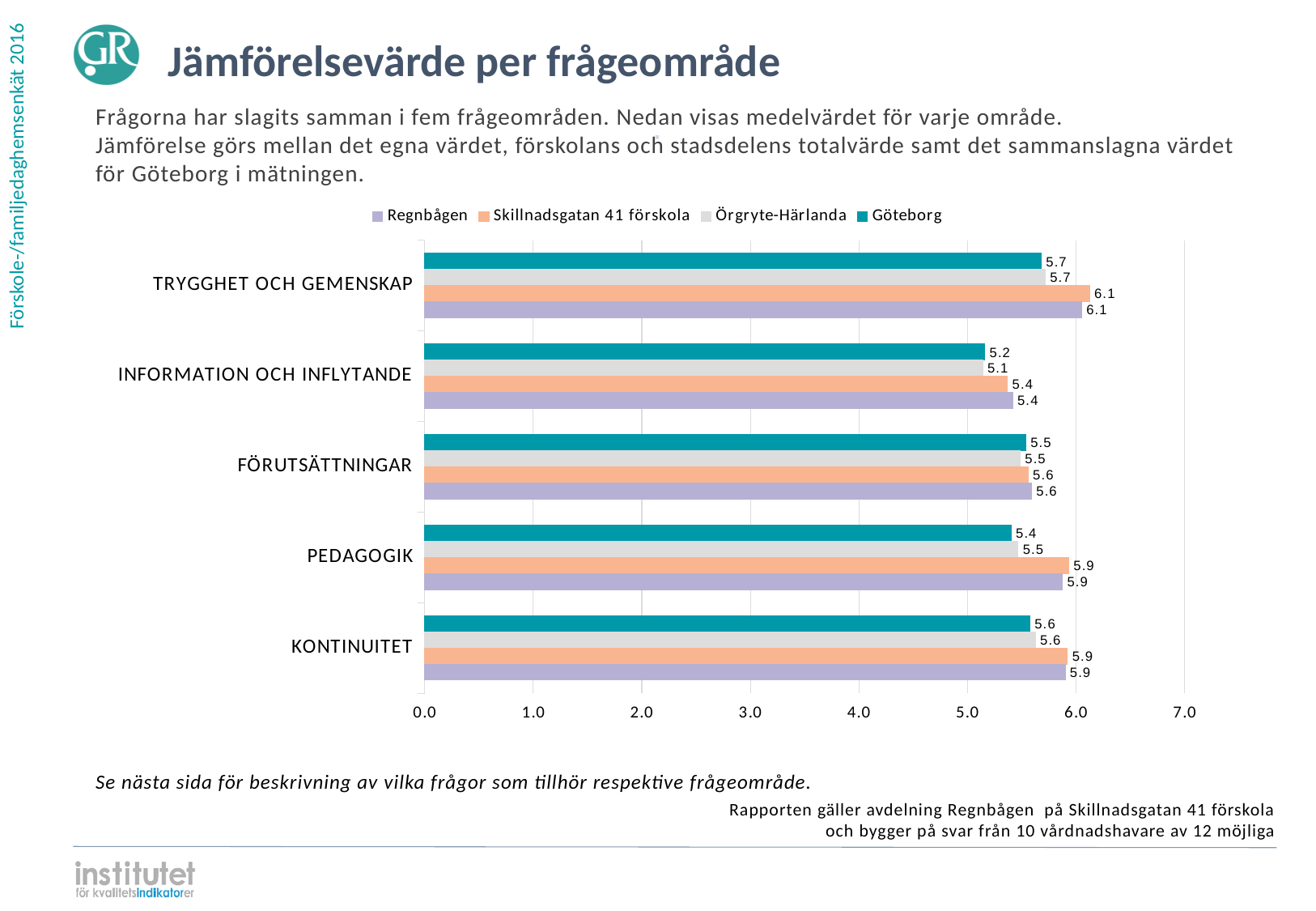
What is the difference between the Regnbågen value and the Göteborg value in the PEDAGOGIK category? 0.5 How many categories are shown on the chart? 5 How many series does the legend list? 4 What is the value for Skillnadsgatan 41 förskola in the KONTINUITET category? 5.9 In the INFORMATION OCH INFLYTANDE category, which is larger: the value for Skillnadsgatan 41 förskola or the value for Örgryte-Härlanda? Skillnadsgatan 41 förskola What kind of chart is shown on the slide? bar chart In which category does Göteborg have its lowest value? INFORMATION OCH INFLYTANDE What is the value for Örgryte-Härlanda in the PEDAGOGIK category? 5.5 Is the value for Regnbågen in the KONTINUITET category greater or less than 5.0? greater What is the value for Regnbågen in the TRYGGHET OCH GEMENSKAP category? 6.1 In which category does Regnbågen have its highest value? TRYGGHET OCH GEMENSKAP What is the value for Göteborg in the INFORMATION OCH INFLYTANDE category? 5.2